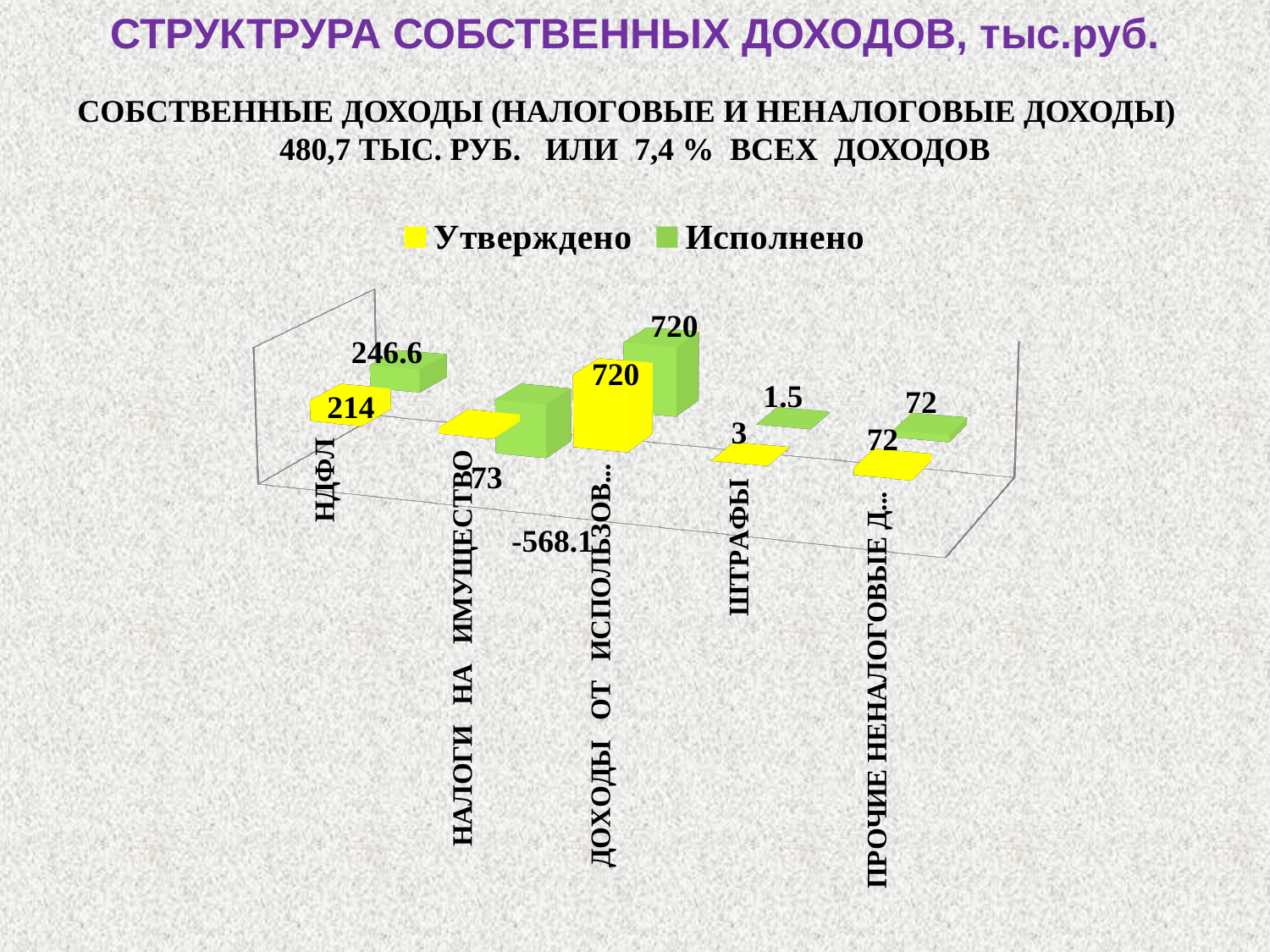
What kind of chart is shown on the slide? Bar chart What is the Исполнено value for ШТРАФЫ? 1.5 What is the Утверждено value for НДФЛ? 214 How many series does the legend list? 2 What is the difference between the Исполнено and Утверждено values for НДФЛ? 32.6 What is the Утверждено value for ШТРАФЫ? 3 What is the Исполнено value for НДФЛ? 246.6 What is the difference between the Утверждено and Исполнено values for ШТРАФЫ? 1.5 Which colour represents the Исполнено series in the legend? Green How many categories are shown on the x axis of the chart? 5 What is the Исполнено value for ПРОЧИЕ НЕНАЛОГОВЫЕ Д...? 72 For НДФЛ, which is larger: Утверждено or Исполнено? Исполнено